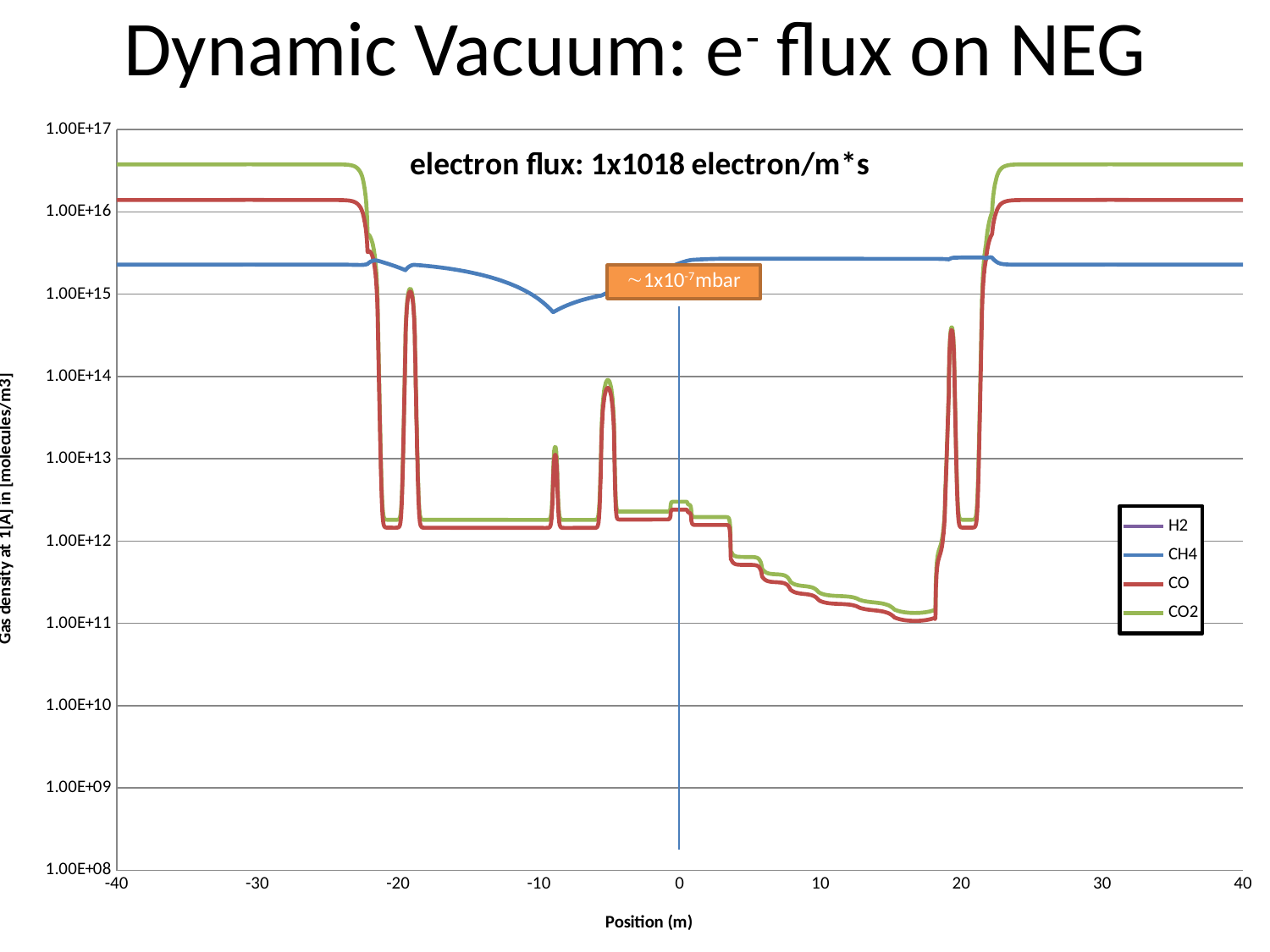
Is the CH4 value at position 10 greater or less than 1.00E+15? greater At position -40, which series has the higher value, CO2 or CH4? CO2 How many series does the chart legend list? 4 Is the CO2 value at position -40 greater or less than 1.00E+16? greater Is the CH4 value at position -40 greater or less than 1.00E+16? less At position 0, which series has the higher value, CH4 or CO? CH4 Does the CO line rise or fall as position goes from 0 to 15? fall What is the title of the x axis? Position (m) What kind of chart is shown on the slide? line chart What text is shown in the orange box on the chart? ~1x10-7 mbar